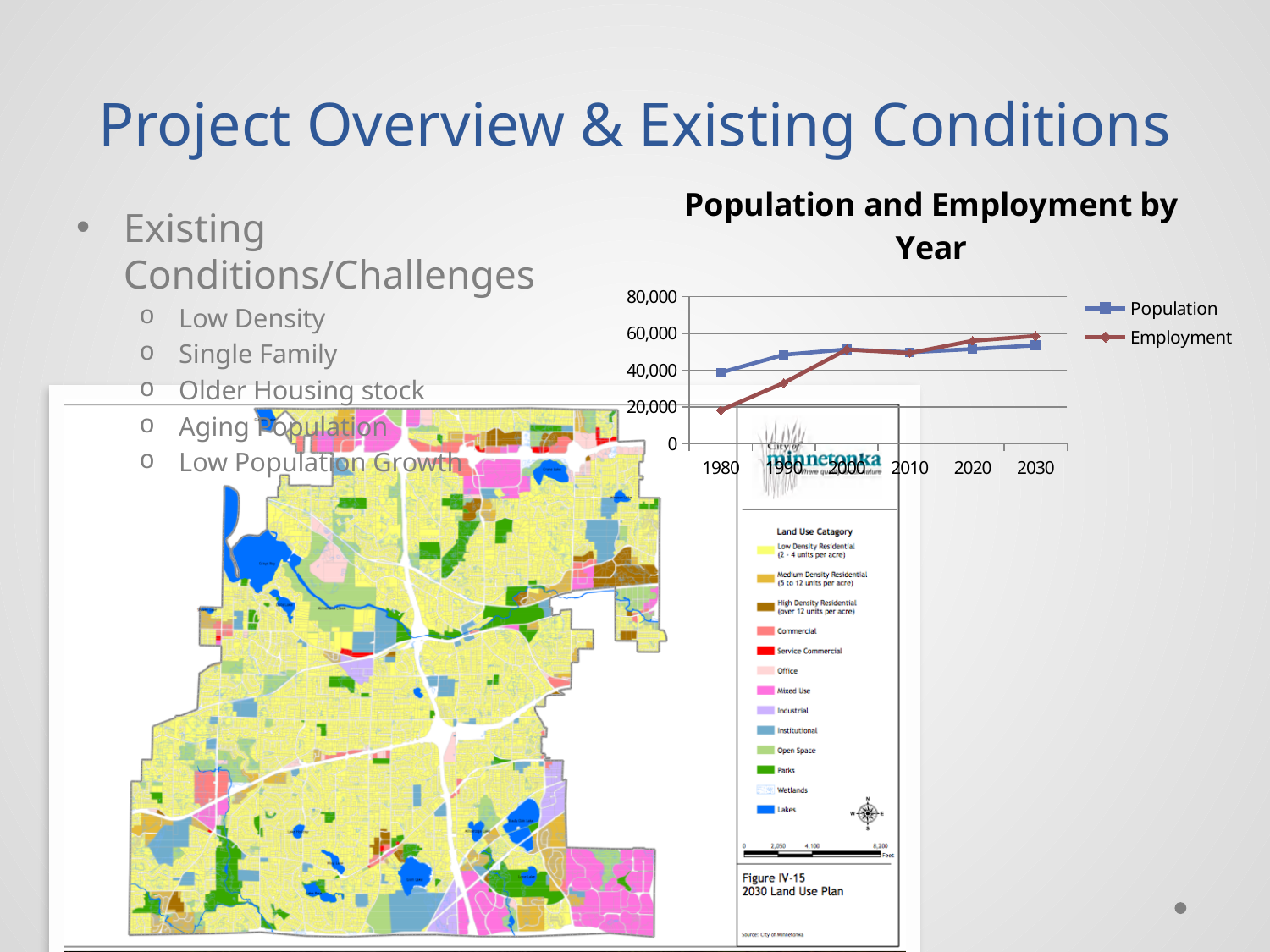
How many years are shown on the x axis of the "Population and Employment by Year" chart? 6 In the "Population and Employment by Year" chart, does the Employment series generally rise or fall from 1980 to 2030? rise In the "Population and Employment by Year" chart, is the Employment value for 1990 greater or less than 40,000? less What kind of chart is "Population and Employment by Year"? line chart In the "Population and Employment by Year" chart, which is larger in 1990, Population or Employment? Population In the "Population and Employment by Year" chart, which year has the lowest Population value? 1980 How many series does the legend of the "Population and Employment by Year" chart list? 2 In the "Population and Employment by Year" chart, is the Employment value for 2030 greater or less than 40,000? greater In the "Population and Employment by Year" chart, which year has the lowest Employment value? 1980 In the "Population and Employment by Year" chart, is the Population value for 1980 greater or less than 20,000? greater In the "Population and Employment by Year" chart, what colour is the Employment line? red In the "Population and Employment by Year" chart, which is larger in 1980, Population or Employment? Population